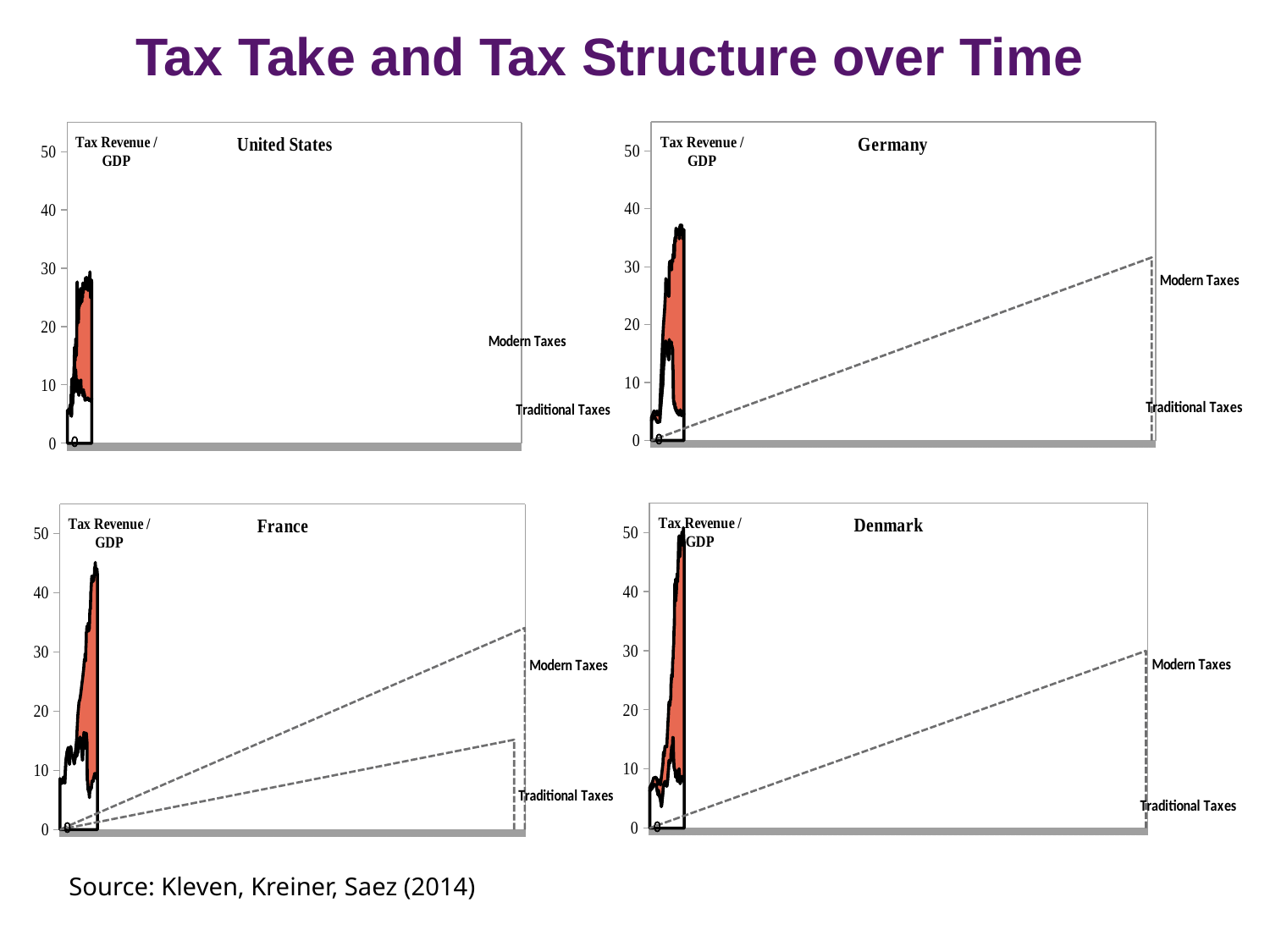
In the Denmark chart, is the peak value of Tax Revenue / GDP greater or less than 40? greater Which country's chart shows the highest peak in Tax Revenue / GDP? Denmark In the United States chart, is the peak value of Tax Revenue / GDP greater or less than 40? less Comparing the France and Germany charts, which country reaches a higher peak in Tax Revenue / GDP? France Which country's chart shows the lowest peak in Tax Revenue / GDP? United States What kind of chart is the United States chart? area chart In the Germany chart, is the peak value of Tax Revenue / GDP greater or less than 40? less What is the highest tick value shown on the y-axis of the Denmark chart? 50 What is the y-axis label shared by the four charts? Tax Revenue / GDP How many charts are shown on the slide? 4